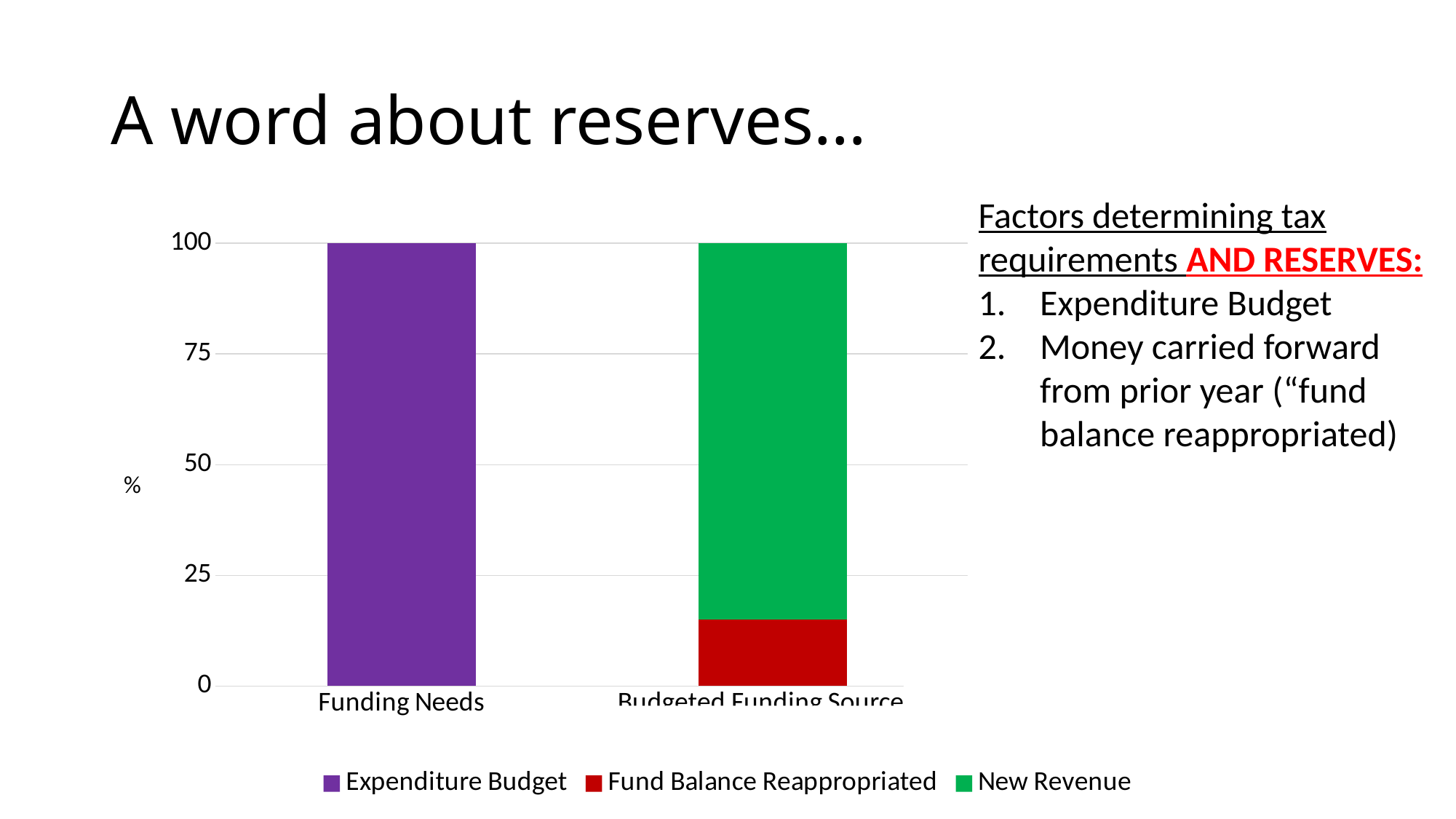
What colour represents Expenditure Budget in the chart legend? Purple Is the value of Fund Balance Reappropriated for Budgeted Funding Source greater or less than 25? less Is the top of the Budgeted Funding Source stacked bar greater or less than 75? greater How many categories are shown on the x axis of the chart? 2 Is the value of New Revenue for Budgeted Funding Source greater or less than 75? greater What kind of chart is shown on the slide? Stacked bar chart How many series does the chart legend list? 3 Which series makes up the largest part of the Budgeted Funding Source bar? New Revenue What is the label on the chart's vertical axis? % What is the value of Expenditure Budget for Funding Needs? 100 Which series makes up the smallest part of the Budgeted Funding Source bar? Fund Balance Reappropriated In the Budgeted Funding Source bar, which is larger: New Revenue or Fund Balance Reappropriated? New Revenue